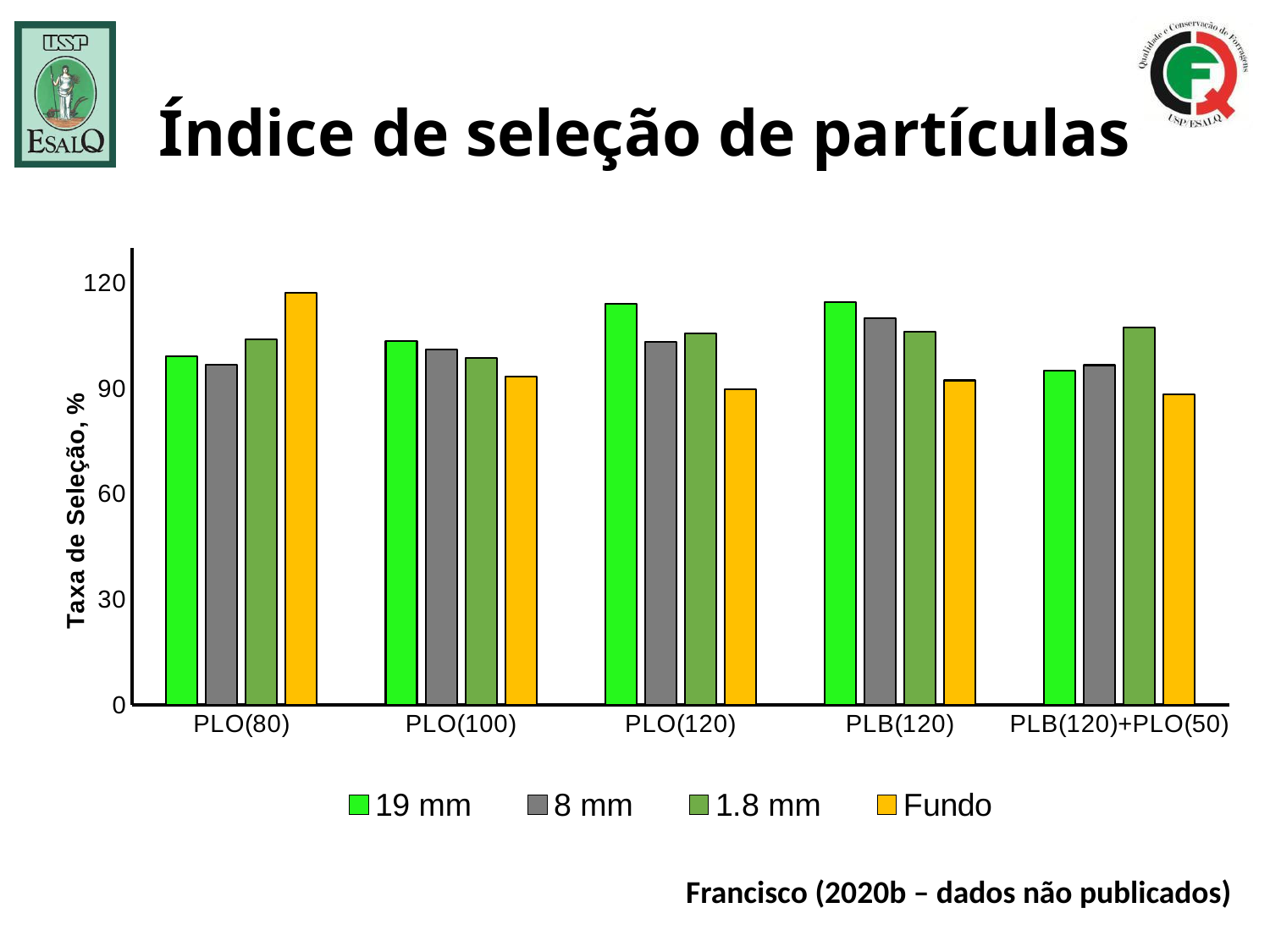
How many categories are shown on the x axis? 5 In the PLO(120) group, which is larger: the 19 mm value or the Fundo value? 19 mm Which series has the lowest value in the PLB(120) group? Fundo Which series has the highest value in the PLO(120) group? 19 mm Is the value for Fundo in PLO(80) greater or less than 90? greater Is the value for 19 mm in PLO(120) greater or less than 90? greater What kind of chart is shown on the slide? Bar chart What is the title of the y axis? Taxa de Seleção, % Is the value for 8 mm in PLB(120) greater or less than 120? less For the Fundo series, which category has the highest value? PLO(80) How many series does the legend list? 4 Which series has the highest value in the PLO(80) group? Fundo